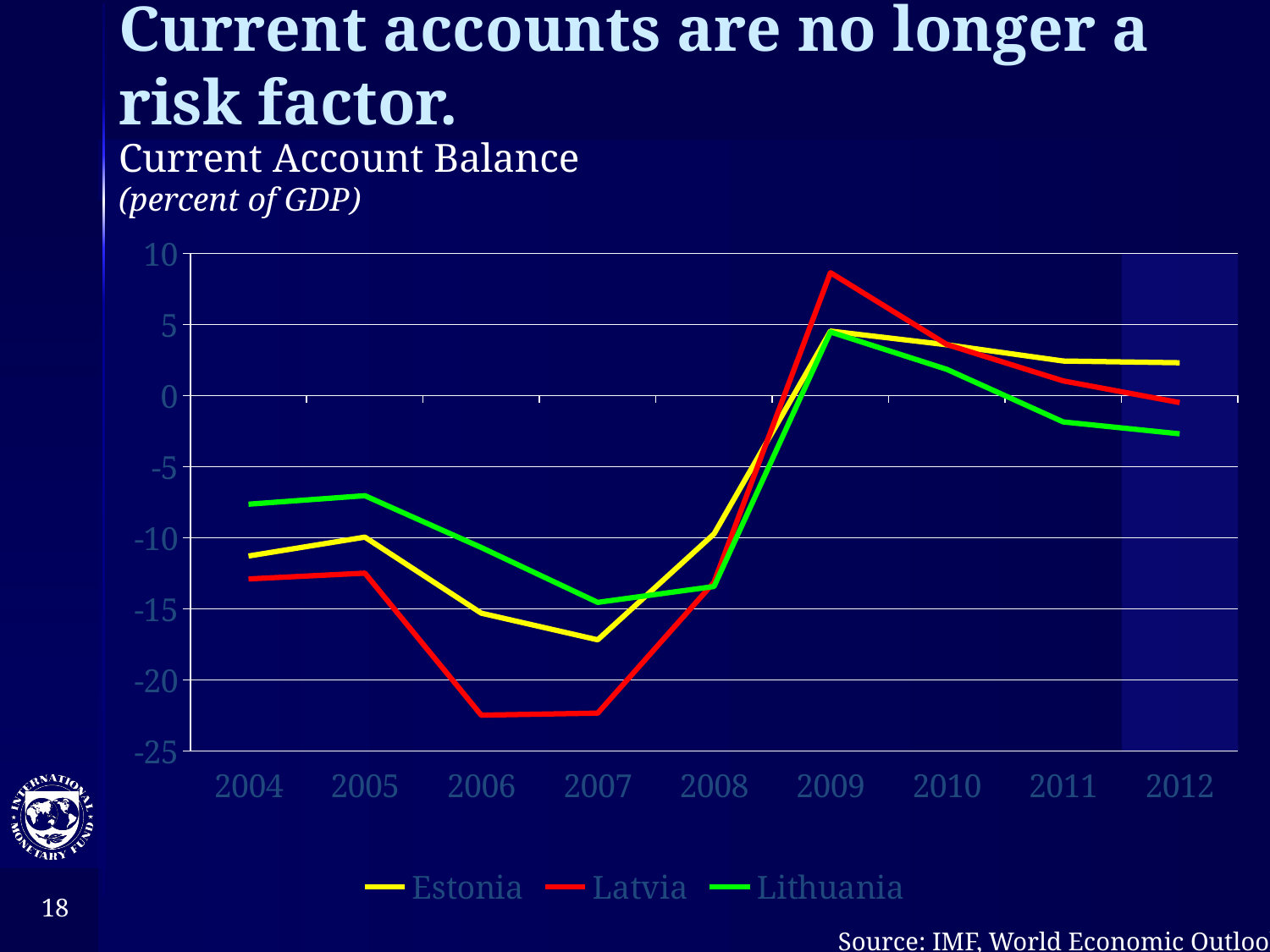
Which country has the lowest current account balance in 2007? Latvia Which country has the highest current account balance in 2009? Latvia Does the Latvia line rise or fall from 2009 to 2012? fall How many series does the legend list? 3 What colour is the line for Latvia? red Is the value for Estonia in 2009 greater or less than 0? greater Which country has the highest current account balance in 2012? Estonia What kind of chart is shown on the slide? line chart Is the value for Lithuania in 2012 greater or less than 0? less How many years are shown on the x axis? 9 In 2004, which is larger: the value for Estonia or the value for Lithuania? Lithuania Is the value for Latvia in 2006 greater or less than -20? less